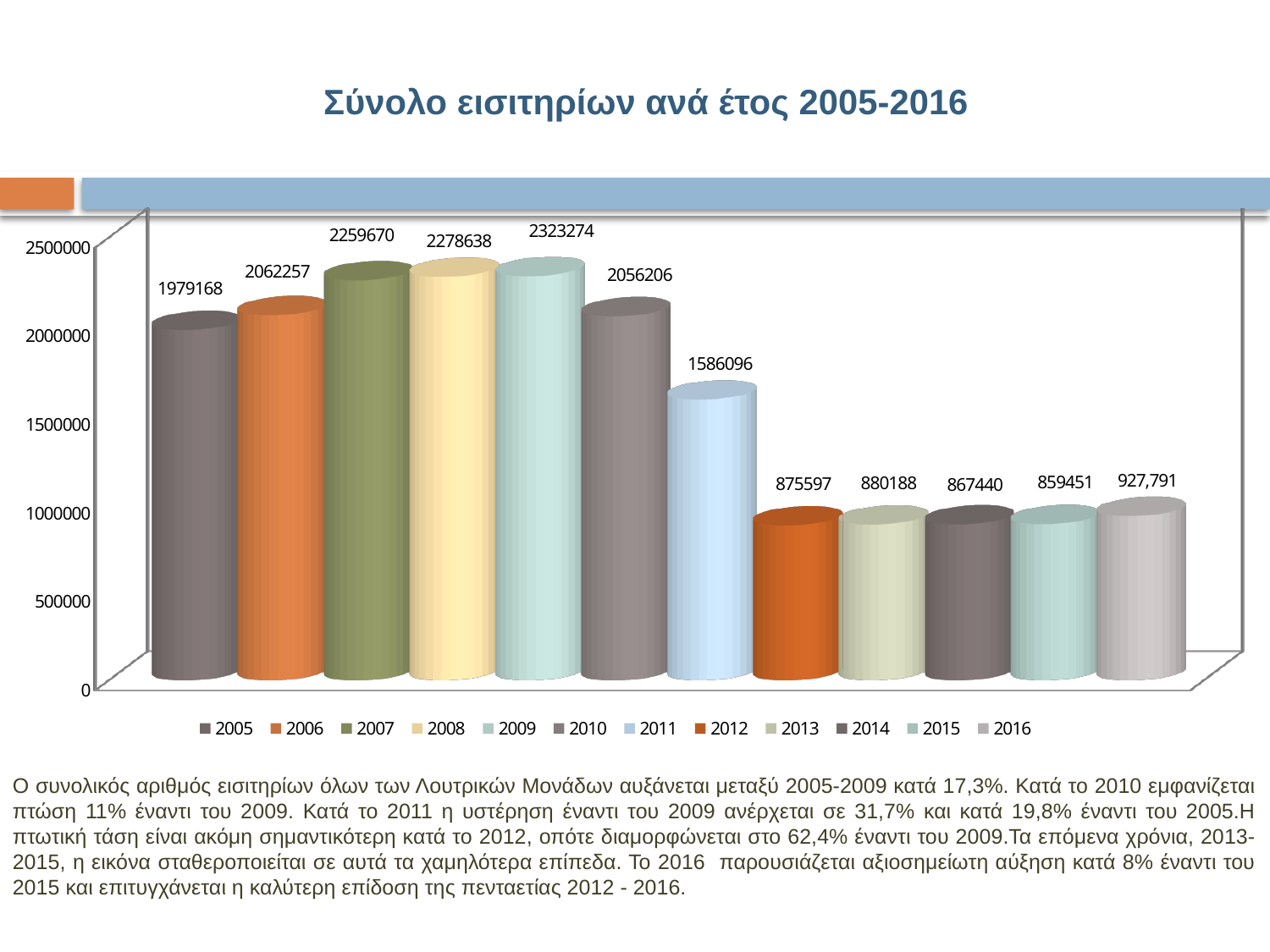
How many years are shown in the chart? 12 How many entries does the legend list? 12 What is the title of the chart? Σύνολο εισιτηρίων ανά έτος 2005-2016 Which is larger, the value for 2007 or the value for 2008? 2008 Which year has the highest value? 2009 Which year has the lowest value? 2015 What is the difference between the values for 2009 and 2010? 267068 What is the value for 2009? 2323274 What is the value for 2011? 1586096 Is the value for 2012 greater or less than 1000000? less What is the value for 2016? 927,791 What kind of chart is shown on the slide? bar chart